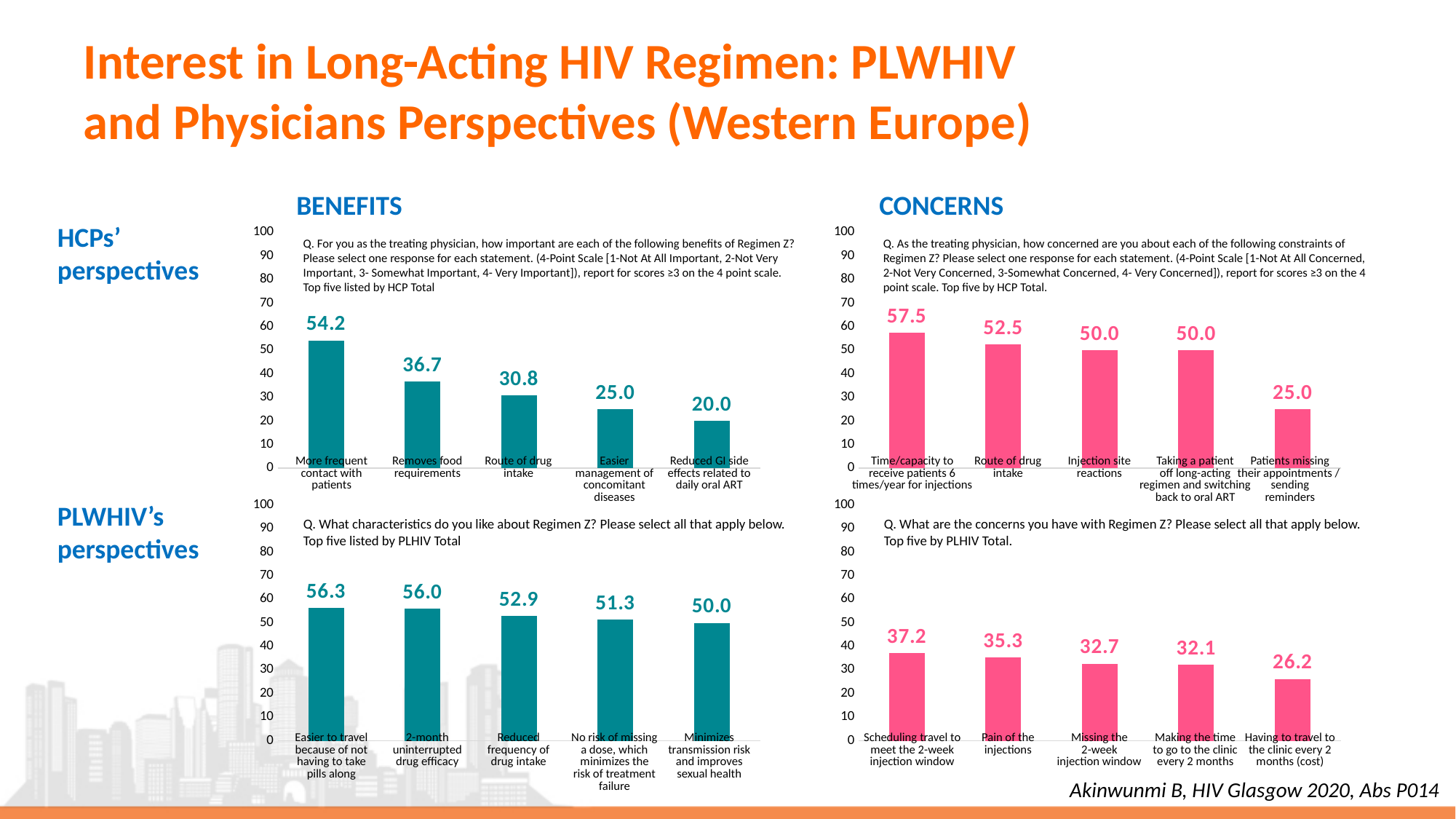
In the HCPs' perspectives BENEFITS chart (top left), do the values rise or fall from left to right? Fall In the PLWHIV's perspectives CONCERNS chart (bottom right), which is larger: 'Pain of the injections' or 'Missing the 2-week injection window'? Pain of the injections What colour are the bars in the CONCERNS charts on the right side of the slide? Pink In the PLWHIV's perspectives BENEFITS chart (bottom left), what is the value for 'Reduced frequency of drug intake'? 52.9 In the PLWHIV's perspectives CONCERNS chart (bottom right), what is the difference between 'Scheduling travel to meet the 2-week injection window' and 'Making the time to go to the clinic every 2 months'? 5.1 How many categories are shown in the PLWHIV's perspectives BENEFITS chart (bottom left)? 5 What type of chart is the HCPs' perspectives CONCERNS chart (top right)? Bar chart In the HCPs' perspectives BENEFITS chart (top left), what is the value for 'Removes food requirements'? 36.7 In the HCPs' perspectives CONCERNS chart (top right), which category has the highest value? Time/capacity to receive patients 6 times/year for injections In the HCPs' perspectives BENEFITS chart (top left), what is the difference between 'More frequent contact with patients' and 'Reduced GI side effects related to daily oral ART'? 34.2 In the PLWHIV's perspectives CONCERNS chart (bottom right), which category has the lowest value? Having to travel to the clinic every 2 months (cost) In the HCPs' perspectives CONCERNS chart (top right), what is the value for 'Patients missing their appointments / sending reminders'? 25.0